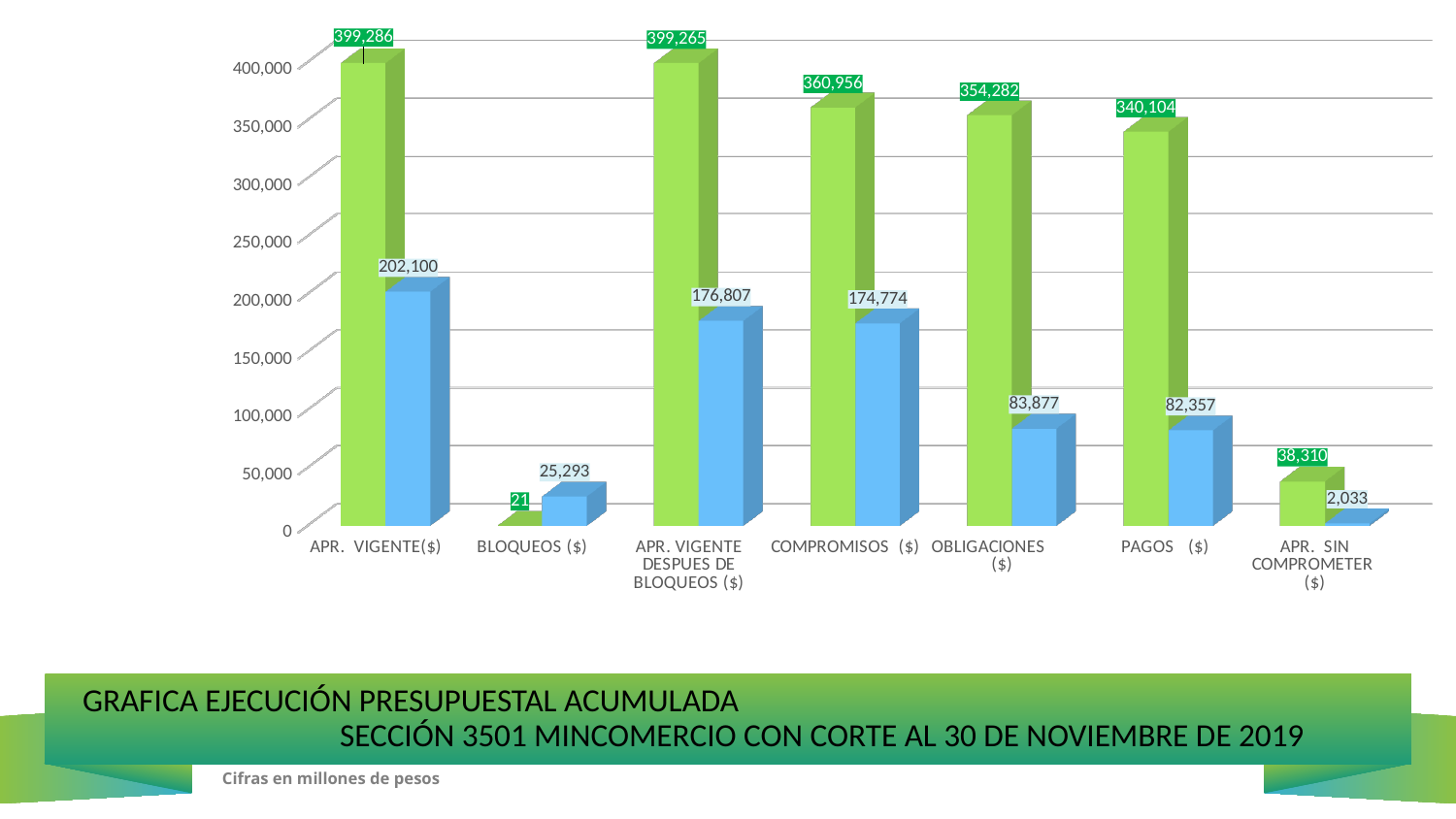
What is the value of the blue bar for APR. SIN COMPROMETER ($)? 2,033 What is the difference between the green bars for COMPROMISOS ($) and OBLIGACIONES ($)? 6,674 Which category has the lowest green bar? BLOQUEOS ($) What is the difference between the blue bars for APR. VIGENTE($) and APR. VIGENTE DESPUES DE BLOQUEOS ($)? 25,293 How many categories are shown on the x axis? 7 Which is larger, the green bar for PAGOS ($) or the green bar for APR. SIN COMPROMETER ($)? PAGOS ($) What is the value of the green bar for COMPROMISOS ($)? 360,956 What is the value of the green bar for BLOQUEOS ($)? 21 What is the value of the blue bar for APR. VIGENTE($)? 202,100 What kind of chart is shown on the slide? bar chart Which category has the highest blue bar? APR. VIGENTE($) Is the value of the blue bar for OBLIGACIONES ($) greater or less than 100,000? less